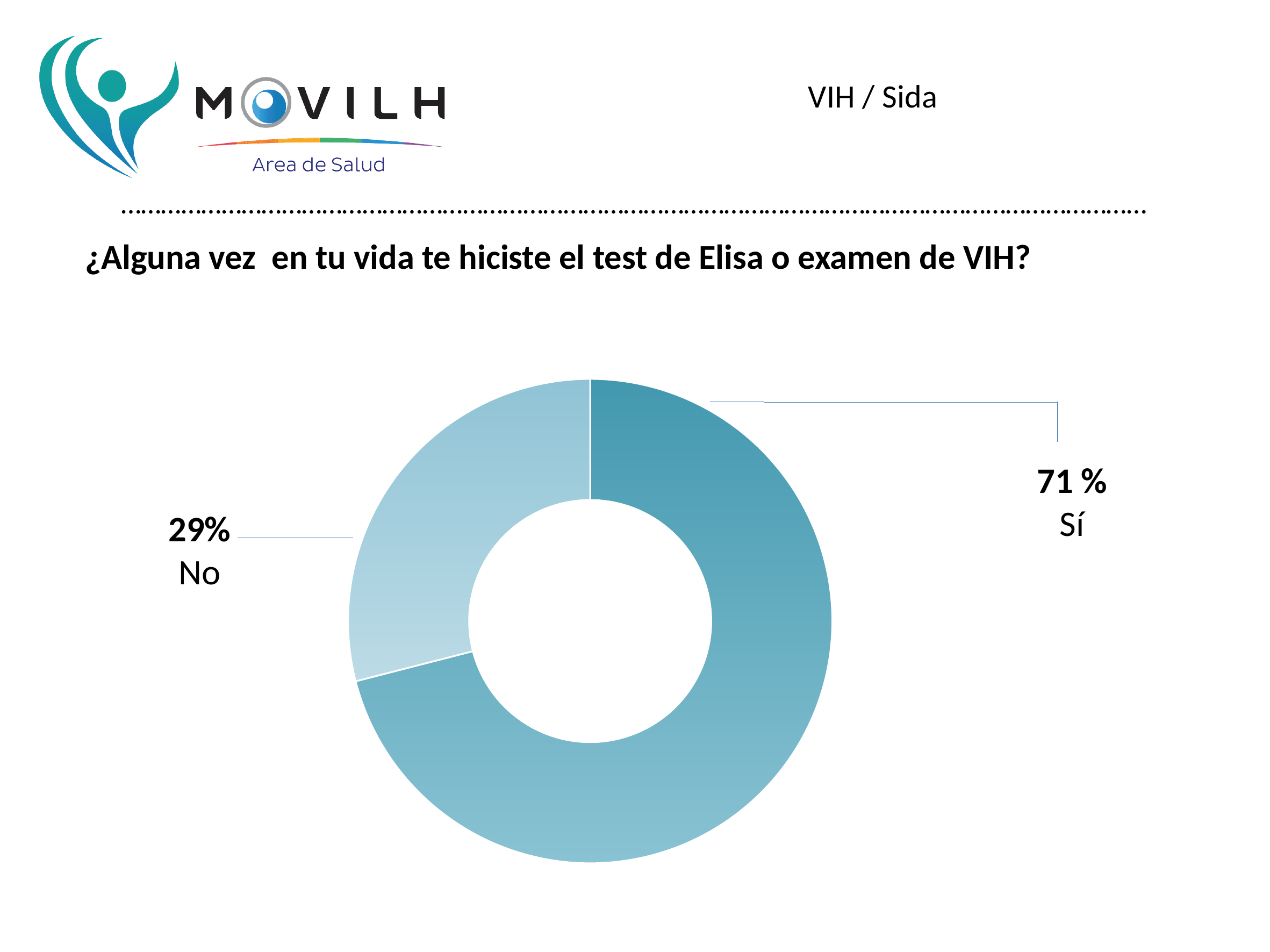
What question does the chart answer, according to the slide heading? ¿Alguna vez en tu vida te hiciste el test de Elisa o examen de VIH? What is the difference in percentage points between the "Sí" and "No" shares? 42 Which response has the largest share of the chart? Sí Which category is shown in the lighter blue colour? No How many categories are shown in the chart? 2 Which is larger, the share for "Sí" or the share for "No"? Sí What percentage of respondents answered "Sí"? 71 % What kind of chart is shown on the slide? Doughnut chart Which response has the smallest share of the chart? No What percentage of respondents answered "No"? 29%